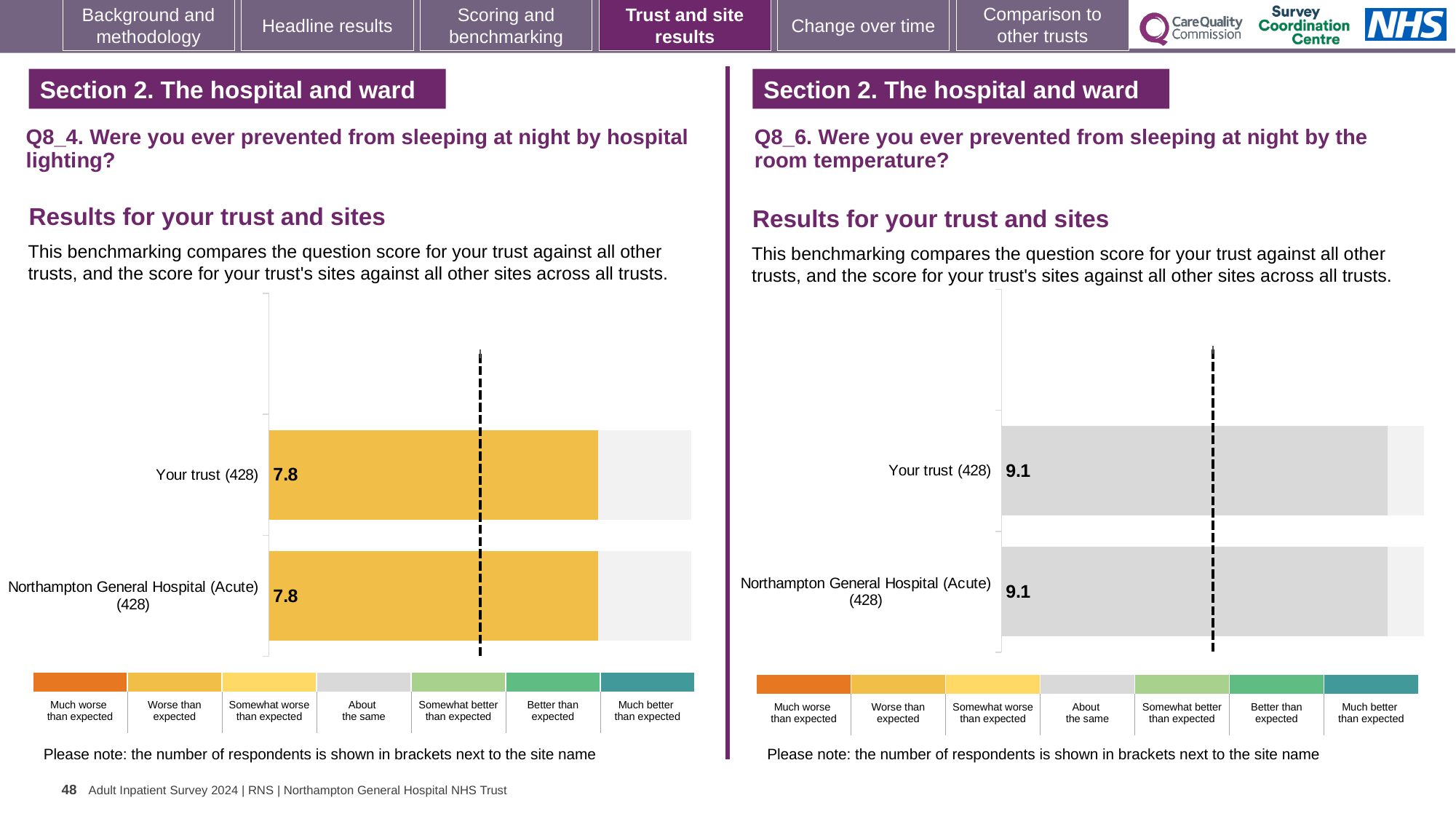
How many bars are plotted in the Q8_6 chart (room temperature)? 2 In the Q8_4 chart (hospital lighting), what is the difference between the score for Your trust and the score for Northampton General Hospital (Acute)? 0 In the Q8_4 chart (hospital lighting), what is the score for Northampton General Hospital (Acute) (428)? 7.8 In the Q8_4 chart (hospital lighting), which benchmark category does the colour of the bars correspond to? Worse than expected In the Q8_4 chart (hospital lighting), what is the score for Your trust (428)? 7.8 What kind of chart is used for the Q8_4 results (hospital lighting)? Bar chart How many bars are plotted in the Q8_4 chart (hospital lighting)? 2 In the Q8_6 chart (room temperature), what is the difference between the score for Your trust and the score for Northampton General Hospital (Acute)? 0 In the Q8_6 chart (room temperature), what is the score for Your trust (428)? 9.1 In the Q8_6 chart (room temperature), which benchmark category does the colour of the bars correspond to? About the same What kind of chart is used for the Q8_6 results (room temperature)? Bar chart In the Q8_6 chart (room temperature), what is the score for Northampton General Hospital (Acute) (428)? 9.1